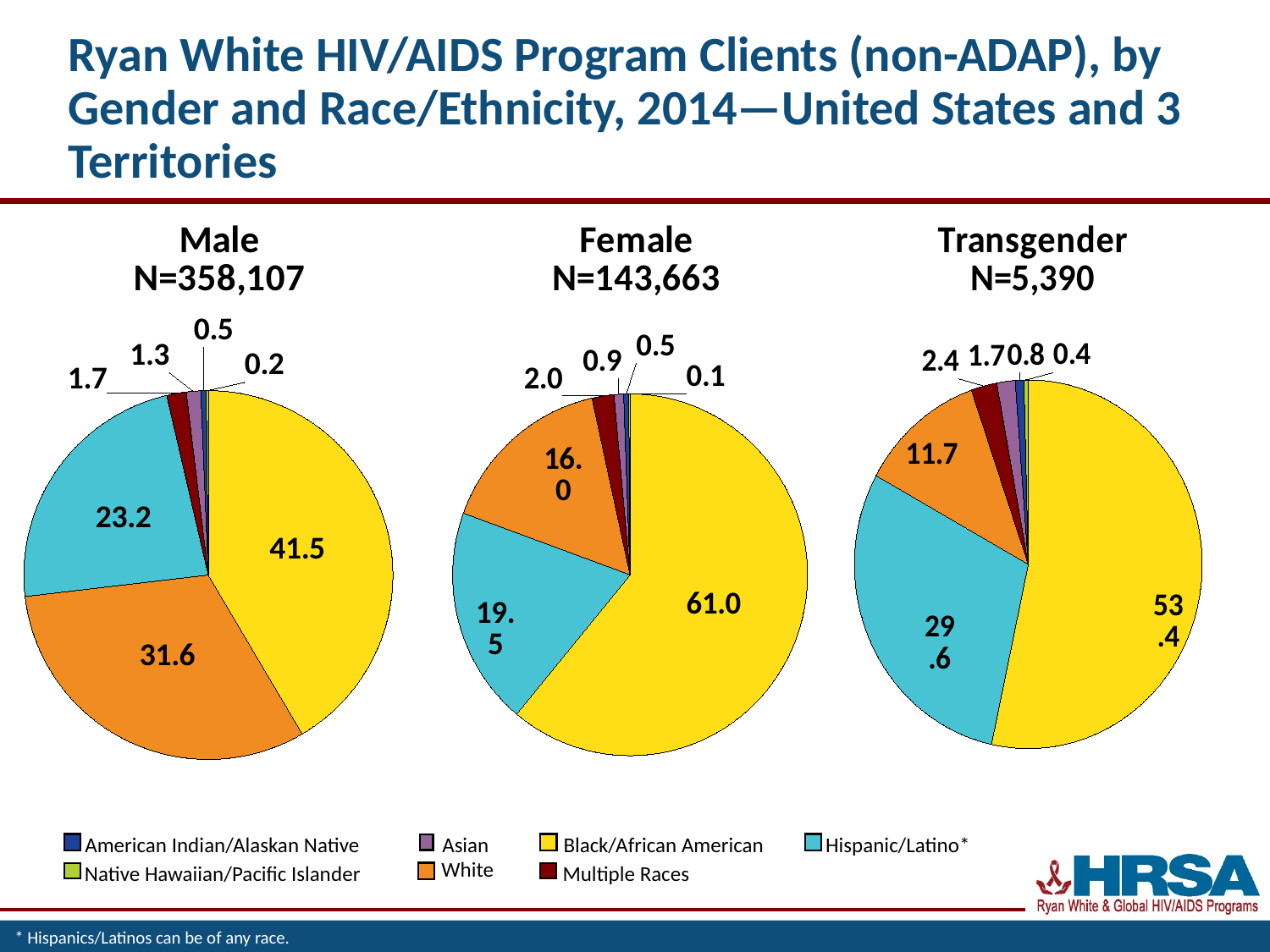
How many race/ethnicity categories does the legend list? 7 In the Female pie chart, which race/ethnicity has the smallest share? Native Hawaiian/Pacific Islander In the Male pie chart, which race/ethnicity has the largest share? Black/African American In the Transgender pie chart, what is the difference between the Black/African American share and the Hispanic/Latino share? 23.8 In the Female pie chart, what percentage of clients are of Multiple Races? 2.0 What type of chart is used on this slide? Pie chart In the Male pie chart, which is larger: the White share or the Hispanic/Latino share? White What is the N value shown for the Female chart? N=143,663 In the Transgender pie chart, what percentage of clients are White? 11.7 In the Female pie chart, what percentage of clients are Hispanic/Latino? 19.5 How many pie charts are shown on the slide? 3 In the Male pie chart, what percentage of clients are Black/African American? 41.5